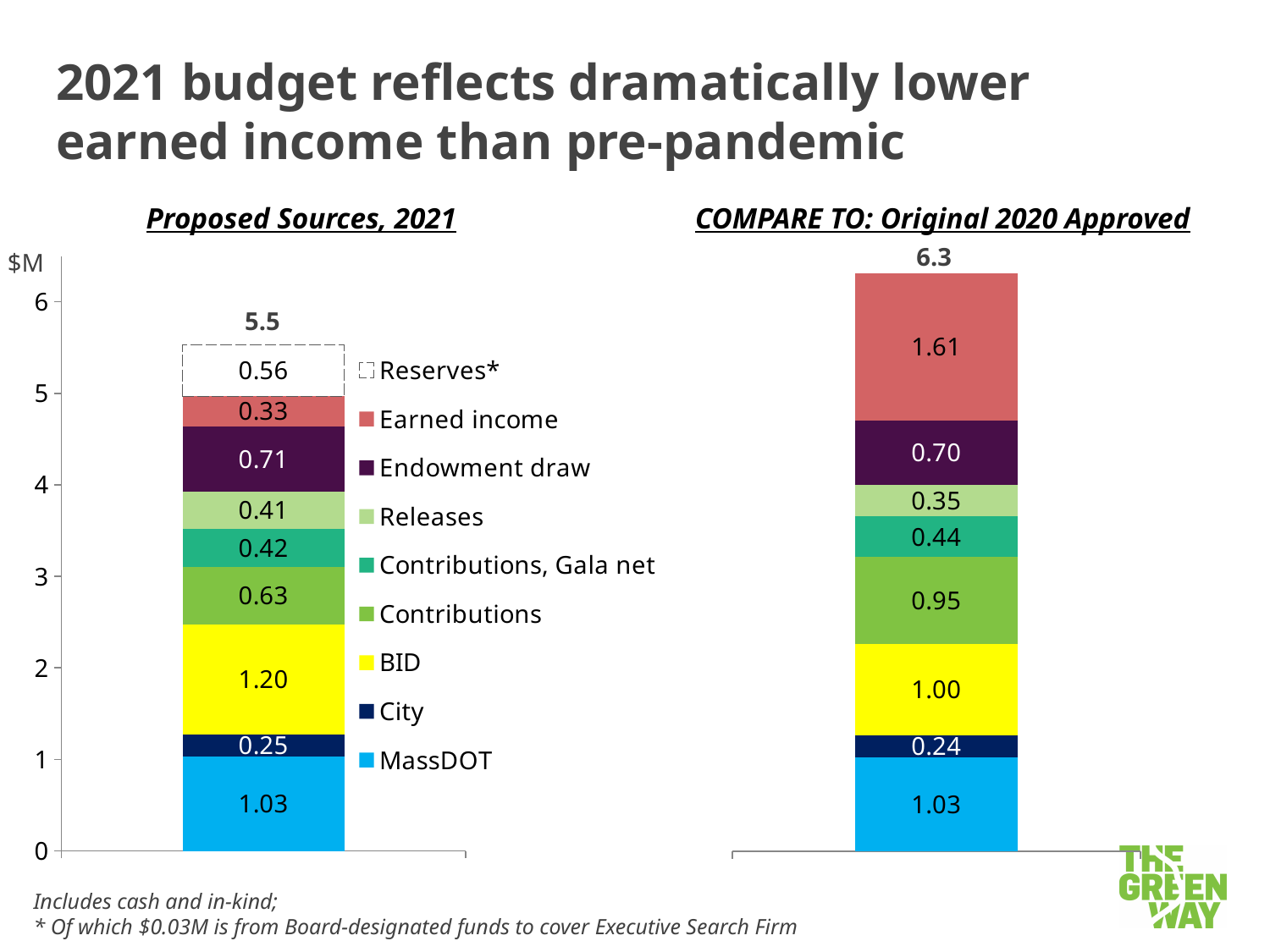
In the COMPARE TO: Original 2020 Approved chart, which source has the smallest value? City What is the difference between the Earned income value in the COMPARE TO: Original 2020 Approved chart and the Earned income value in the Proposed Sources, 2021 chart? 1.28 In the COMPARE TO: Original 2020 Approved chart, what is the value for Earned income? 1.61 In the Proposed Sources, 2021 chart, which source has the largest value? BID What kind of chart is used on this slide? Stacked bar chart In the Proposed Sources, 2021 chart, which is larger: Endowment draw or Contributions? Endowment draw How many entries does the legend list? 9 In the Proposed Sources, 2021 chart, what is the value for BID? 1.20 What is the total of the stacked bar in the COMPARE TO: Original 2020 Approved chart? 6.3 In the Proposed Sources, 2021 chart, what is the value for Earned income? 0.33 What is the total of the stacked bar in the Proposed Sources, 2021 chart? 5.5 In the COMPARE TO: Original 2020 Approved chart, what is the value for Contributions? 0.95